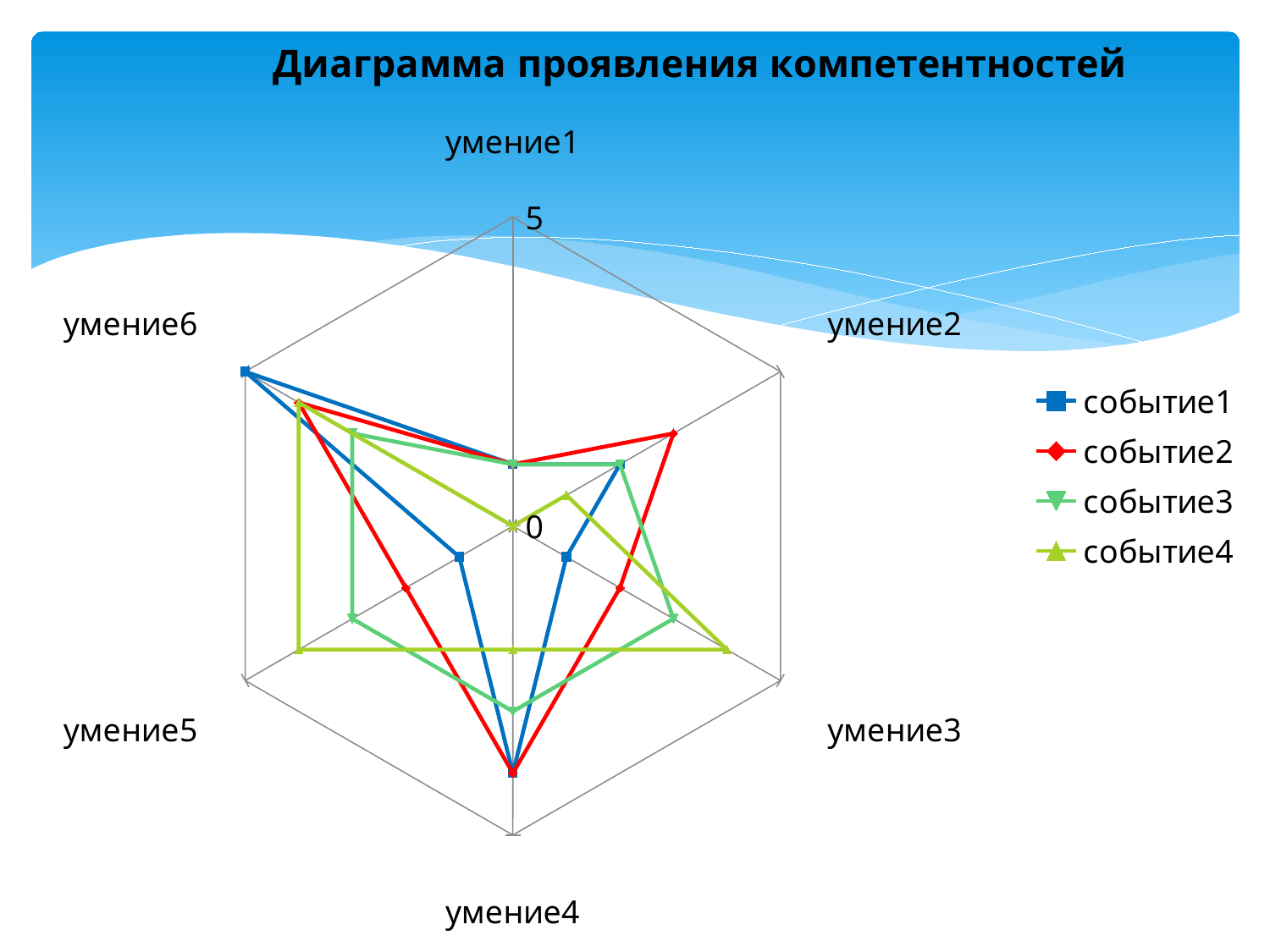
How many categories (умения) are plotted on the chart? 6 What is the title of the chart? Диаграмма проявления компетентностей Which series has the highest value for умение3? событие4 For умение4, which is larger: the value of событие1 or событие4? событие1 Which series has the lowest value for умение1? событие4 What is the value of событие1 for умение6? 5 How many series does the legend list? 4 Which series has the highest value for умение2? событие2 What kind of chart is shown on the slide? radar chart For which category does событие4 have its lowest value? умение1 What is the value of событие4 for умение1? 0